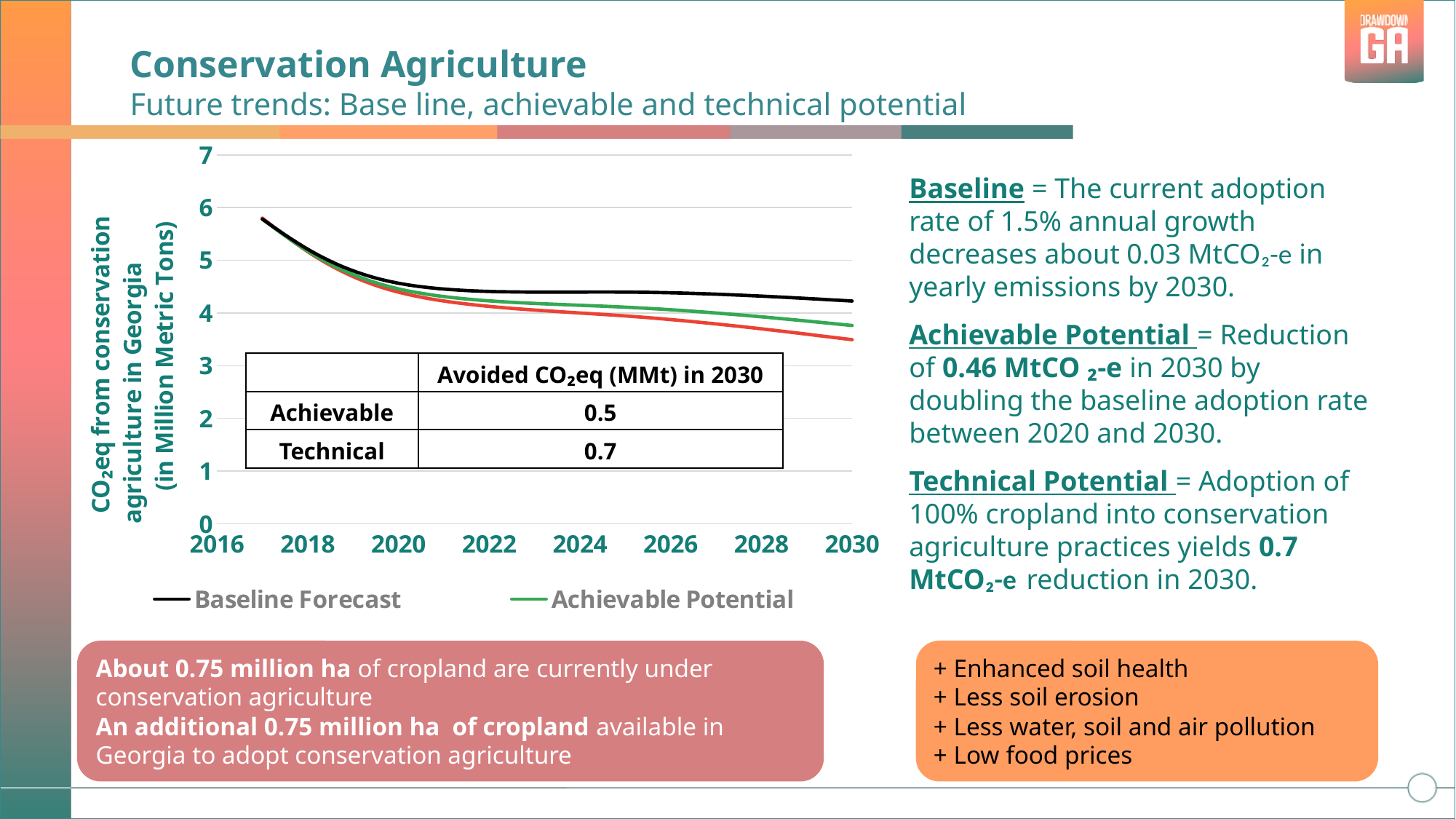
According to the table on the chart, what is the avoided CO₂eq (MMt) in 2030 for Technical? 0.7 Which row in the table has the higher avoided CO₂eq (MMt) in 2030? Technical According to the table on the chart, what is the avoided CO₂eq (MMt) in 2030 for Achievable? 0.5 What colour is the Baseline Forecast line in the legend? black What kind of chart is shown on the slide? line chart In 2030, which line is higher: Baseline Forecast or Achievable Potential? Baseline Forecast Is the Baseline Forecast value in 2030 greater or less than 5? less Is the Achievable Potential value in 2030 greater or less than 5? less Do the values of the Baseline Forecast line rise or fall from 2017 to 2030? fall What is the difference between the Technical and Achievable avoided CO₂eq (MMt) in 2030 shown in the table? 0.2 Is the Baseline Forecast value at the start of the lines (2017) greater or less than 5? greater How many series does the chart legend list? 2